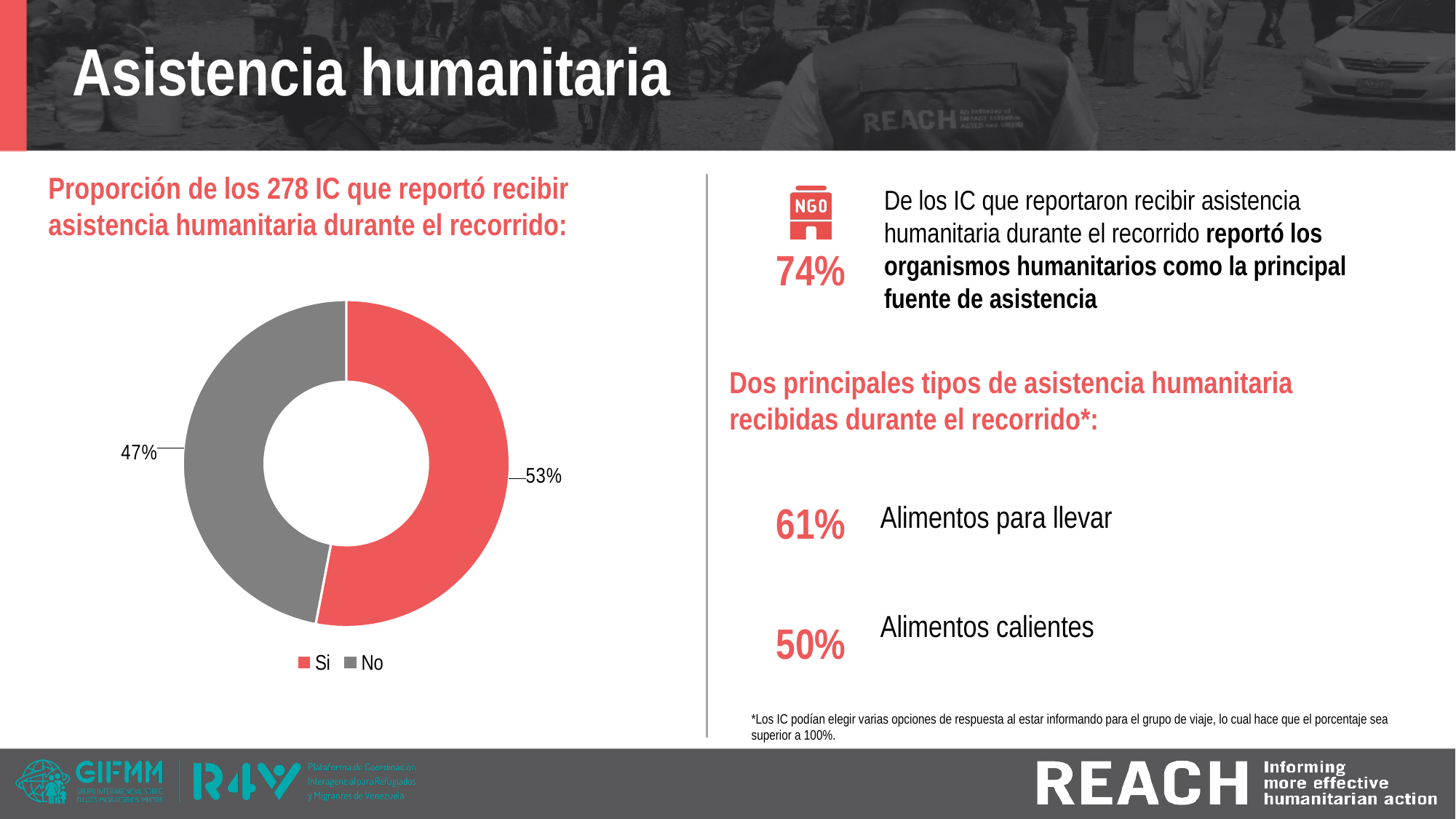
What percentage of the 278 IC reported receiving humanitarian assistance during the journey (the 'Si' slice)? 53% What is the difference in percentage points between the 'Si' and 'No' slices? 6 What type of chart is used to show the proportion of IC that reported receiving humanitarian assistance? Pie chart (donut) Is the value for 'Si' greater or less than 50%? greater How many categories does the donut chart show? 2 Which slice of the donut chart is larger, 'Si' or 'No'? Si Which category has the smallest share in the donut chart? No What percentage is shown for the 'No' slice of the donut chart? 47% What colour represents the 'Si' category in the donut chart? Red What are the two legend entries of the donut chart? Si, No Is the value for 'No' greater or less than 50%? less